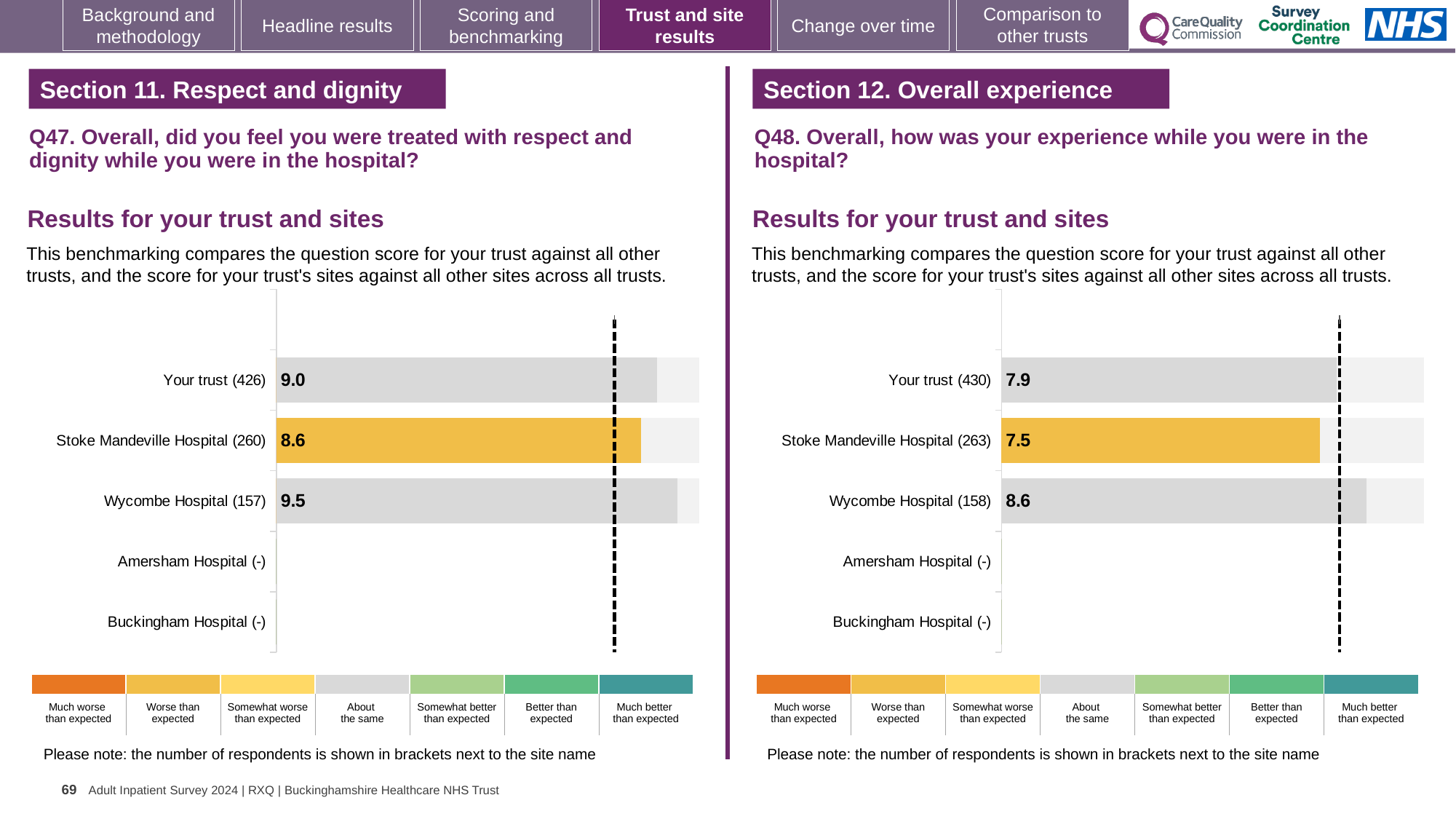
In the Q47 chart on the left, what is the difference between the scores for Wycombe Hospital and Stoke Mandeville Hospital? 0.9 In the Q48 chart on the right, what is the score for Your trust? 7.9 In the Q47 chart on the left, what is the score for Your trust? 9.0 In the Q48 chart on the right, which has the larger score, Your trust or Wycombe Hospital? Wycombe Hospital In the Q47 chart on the left, what is the score for Wycombe Hospital? 9.5 In the Q48 chart on the right, what is the score for Stoke Mandeville Hospital? 7.5 In the Q48 chart on the right, what is the difference between the scores for Wycombe Hospital and Your trust? 0.7 In the Q47 chart on the left, which site or trust has the highest score? Wycombe Hospital In the Q48 chart on the right, which site or trust has the lowest score? Stoke Mandeville Hospital In the Q48 chart on the right, how many respondents are shown in brackets for Wycombe Hospital? 158 What kind of chart is the Q48 chart on the right? Bar chart How many sites or trusts are listed on the y axis of the Q47 chart on the left? 5